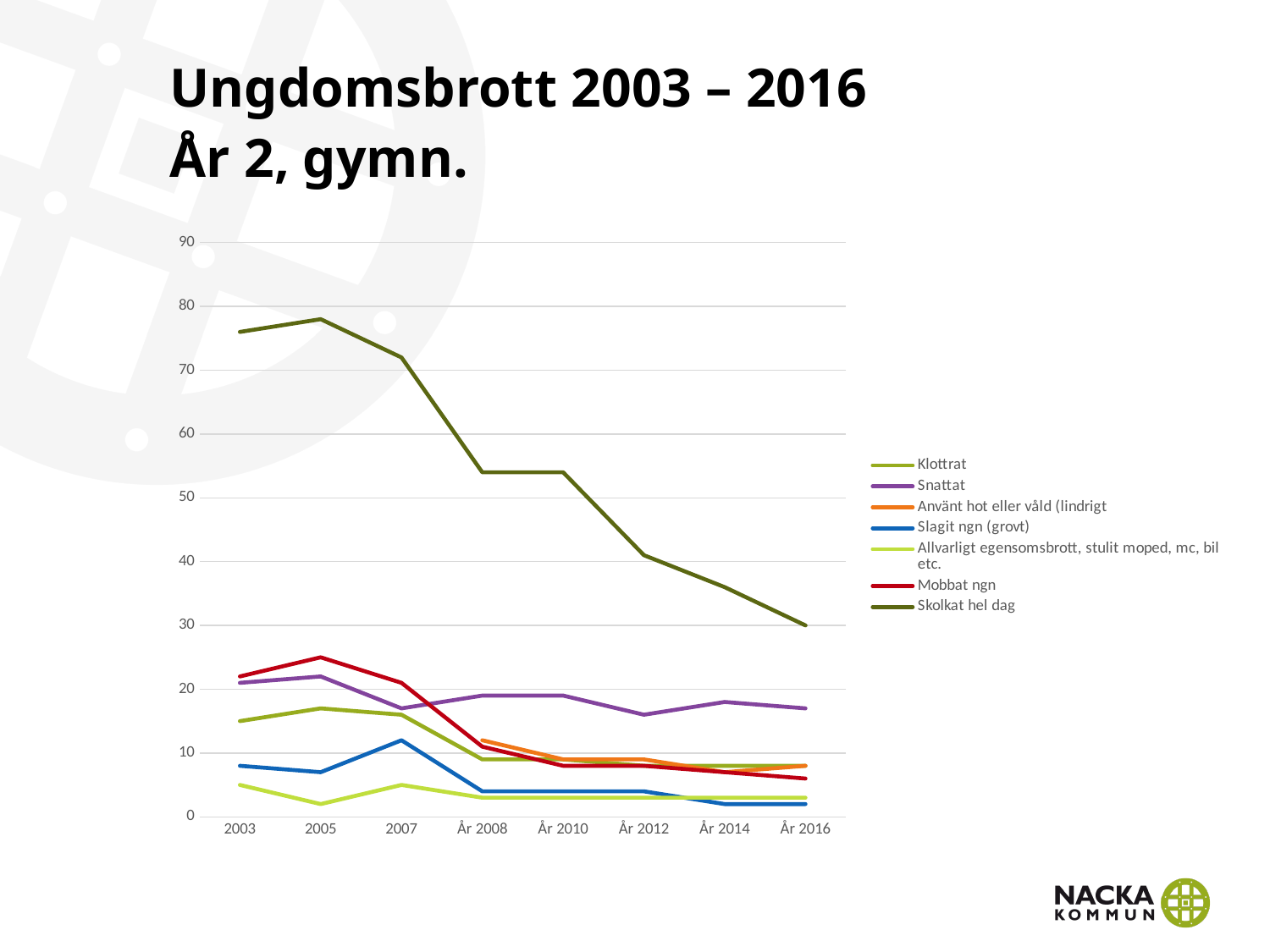
How many series does the legend list? 7 How many points are there along the x axis? 8 What kind of chart is shown on the slide? line chart Does the value for Skolkat hel dag rise or fall from 2005 to År 2016? fall Is the value for Skolkat hel dag in 2003 greater or less than 70? greater Which is larger in 2005, Mobbat ngn or Klottrat? Mobbat ngn Which series has the lowest value in 2005? Allvarligt egensomsbrott, stulit moped, mc, bil etc. Which series has the highest value in 2003? Skolkat hel dag Is the value for Slagit ngn (grovt) in 2007 greater or less than 10? greater Is the value for Mobbat ngn in 2005 greater or less than 20? greater What is the title of the slide? Ungdomsbrott 2003 – 2016 År 2, gymn. What is the value for Skolkat hel dag in År 2016? 30